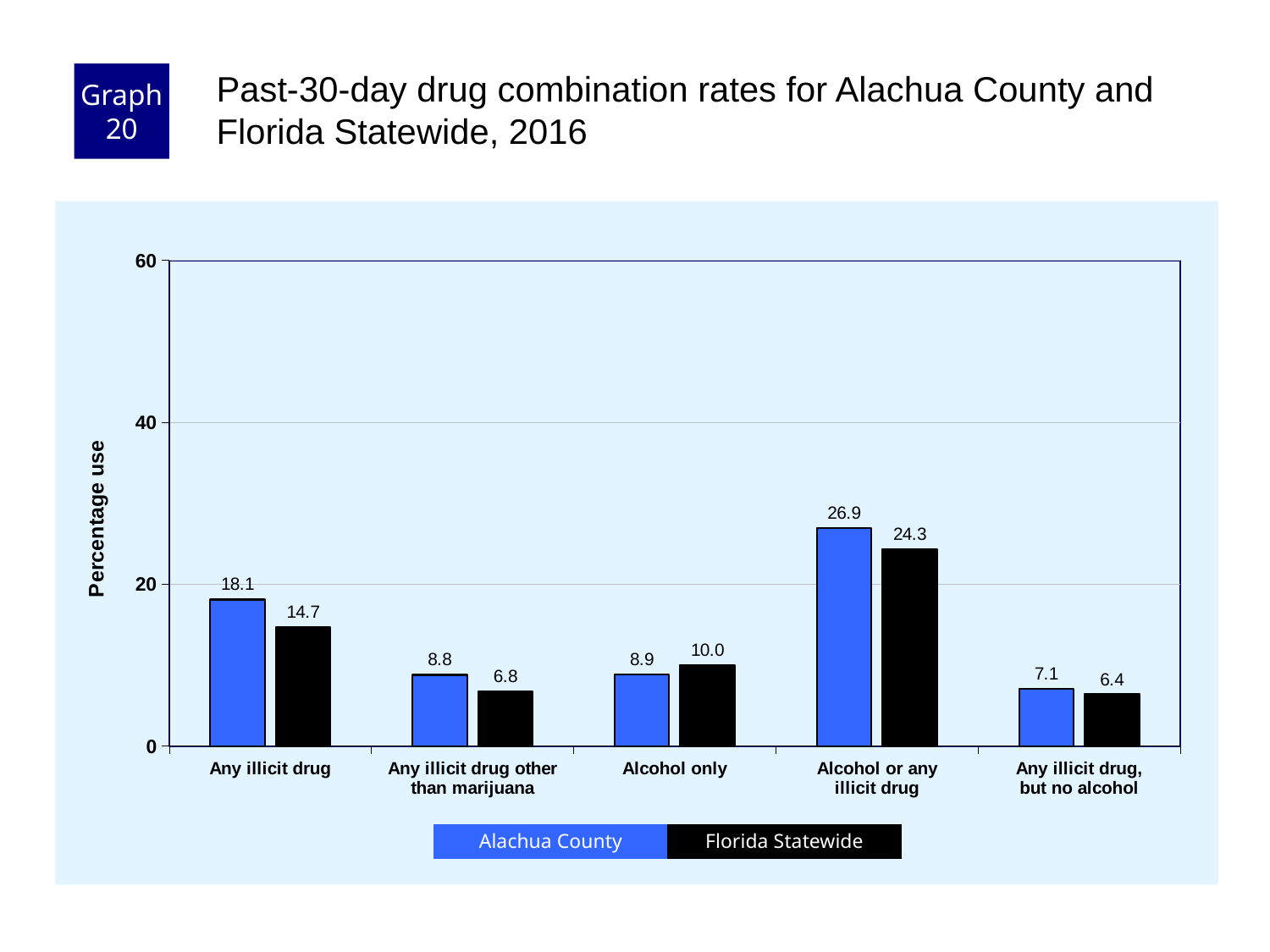
What is the Florida Statewide value for Any illicit drug, but no alcohol? 6.4 What kind of chart is shown? bar chart What is the difference between the Alachua County and Florida Statewide values for Alcohol or any illicit drug? 2.6 What is the Florida Statewide value for Alcohol only? 10.0 How many categories are shown on the x axis? 5 Which category has the highest Alachua County value? Alcohol or any illicit drug Which category has the lowest Florida Statewide value? Any illicit drug, but no alcohol Is the Florida Statewide value for Alcohol or any illicit drug greater or less than 20? greater For Alcohol only, which is larger: Alachua County or Florida Statewide? Florida Statewide What is the Alachua County value for Any illicit drug? 18.1 What is the label of the y axis? Percentage use How many series does the legend list? 2